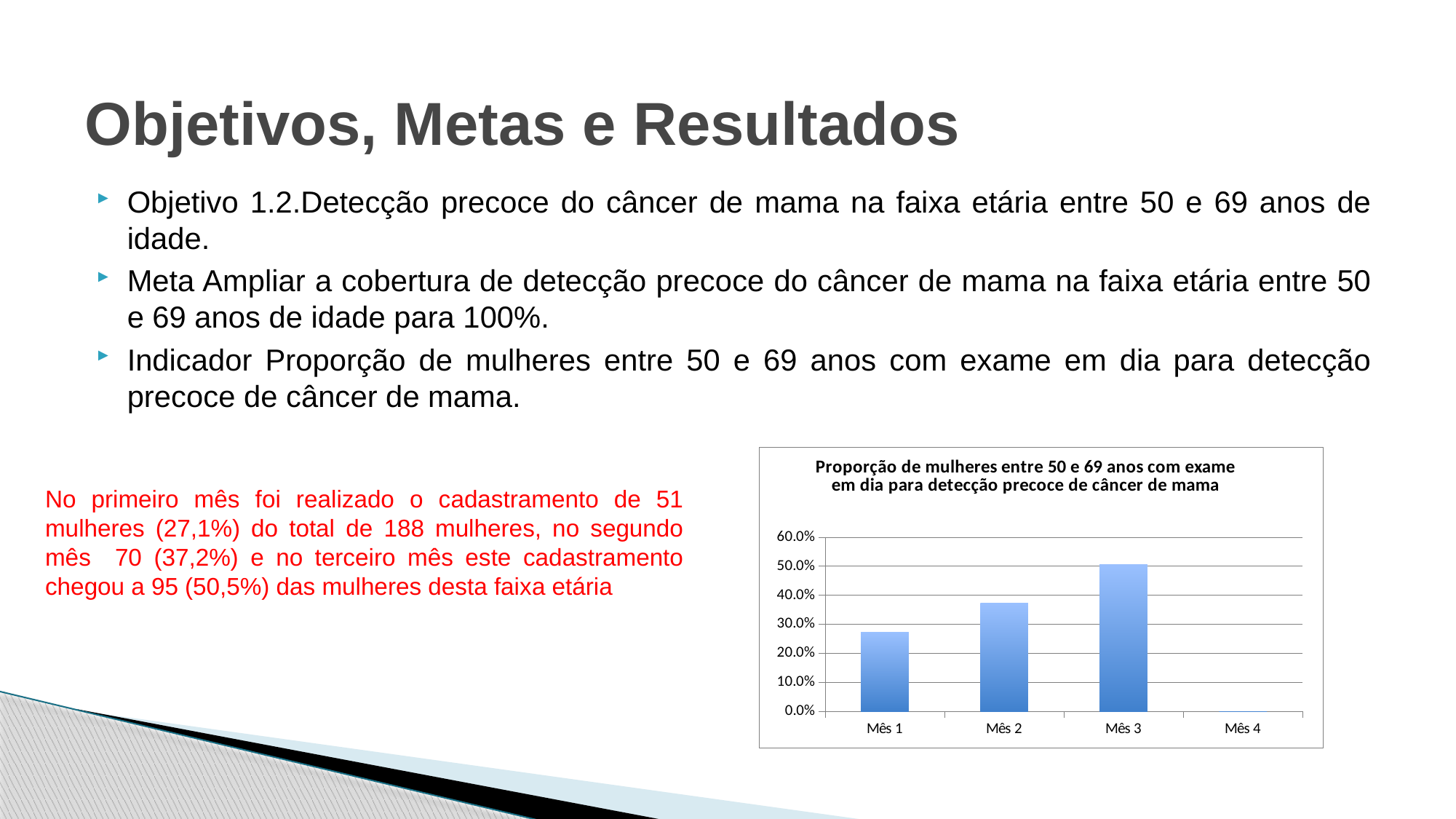
Which is larger, the value for Mês 2 or the value for Mês 3? Mês 3 What kind of chart is shown on the slide? bar chart Do the bar values rise or fall from Mês 1 to Mês 3? rise Is the value for Mês 2 greater or less than 30.0%? greater Among the months with a bar plotted, which has the lowest value? Mês 1 Which month has the tallest bar in the chart? Mês 3 Is the value for Mês 2 greater or less than 40.0%? less How many categories are shown on the x axis of the chart? 4 Is the value for Mês 1 greater or less than 30.0%? less Which category on the x axis has no bar plotted? Mês 4 What is the title of the chart? Proporção de mulheres entre 50 e 69 anos com exame em dia para detecção precoce de câncer de mama